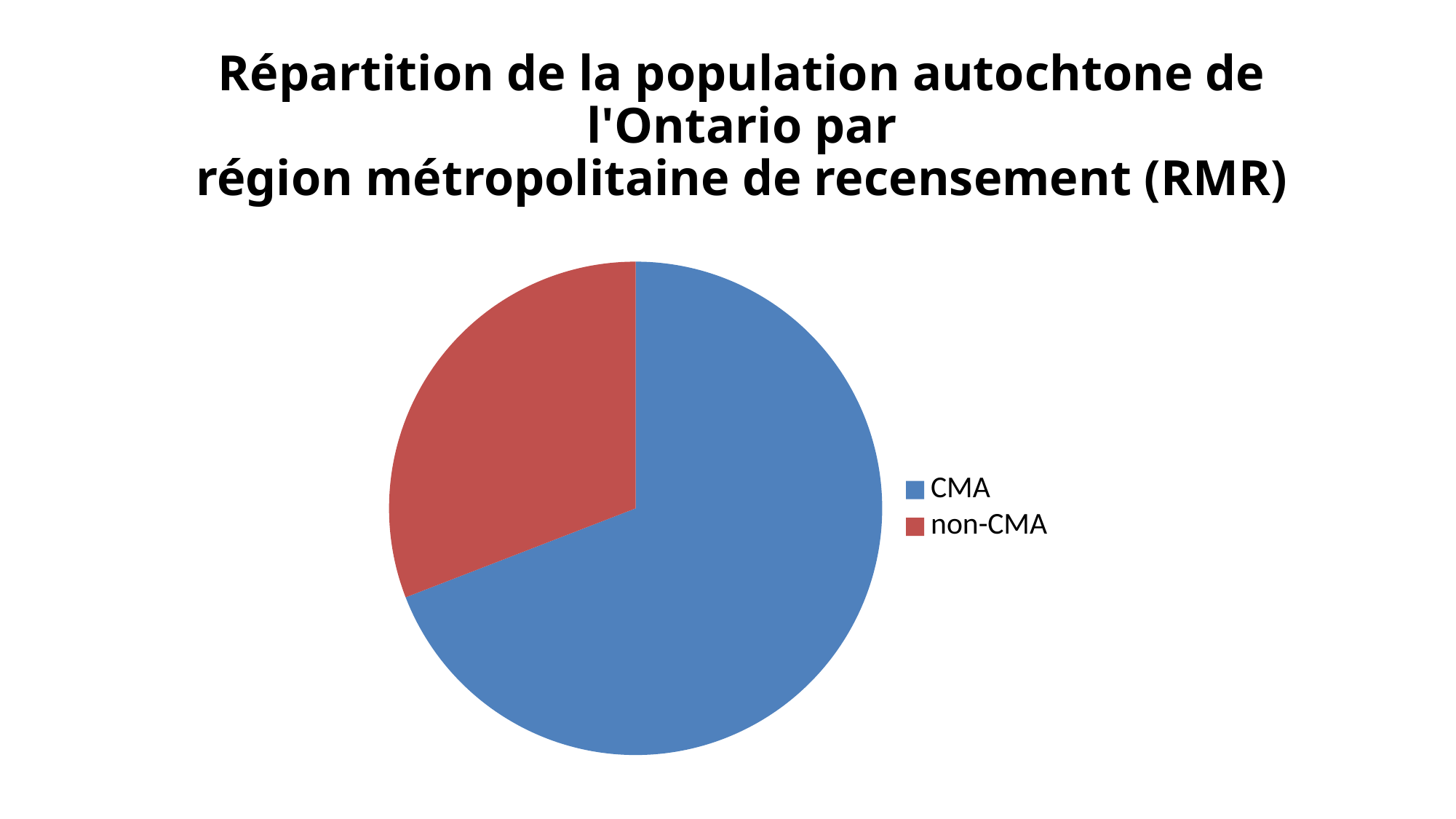
How many entries does the legend list? 2 What colour is the non-CMA slice? red What kind of chart is shown on the slide? pie chart Which category has the smallest slice of the pie? non-CMA Which slice is larger, CMA or non-CMA? CMA Which category has the largest slice of the pie? CMA How many slices does the pie chart have? 2 What colour is the CMA slice? blue